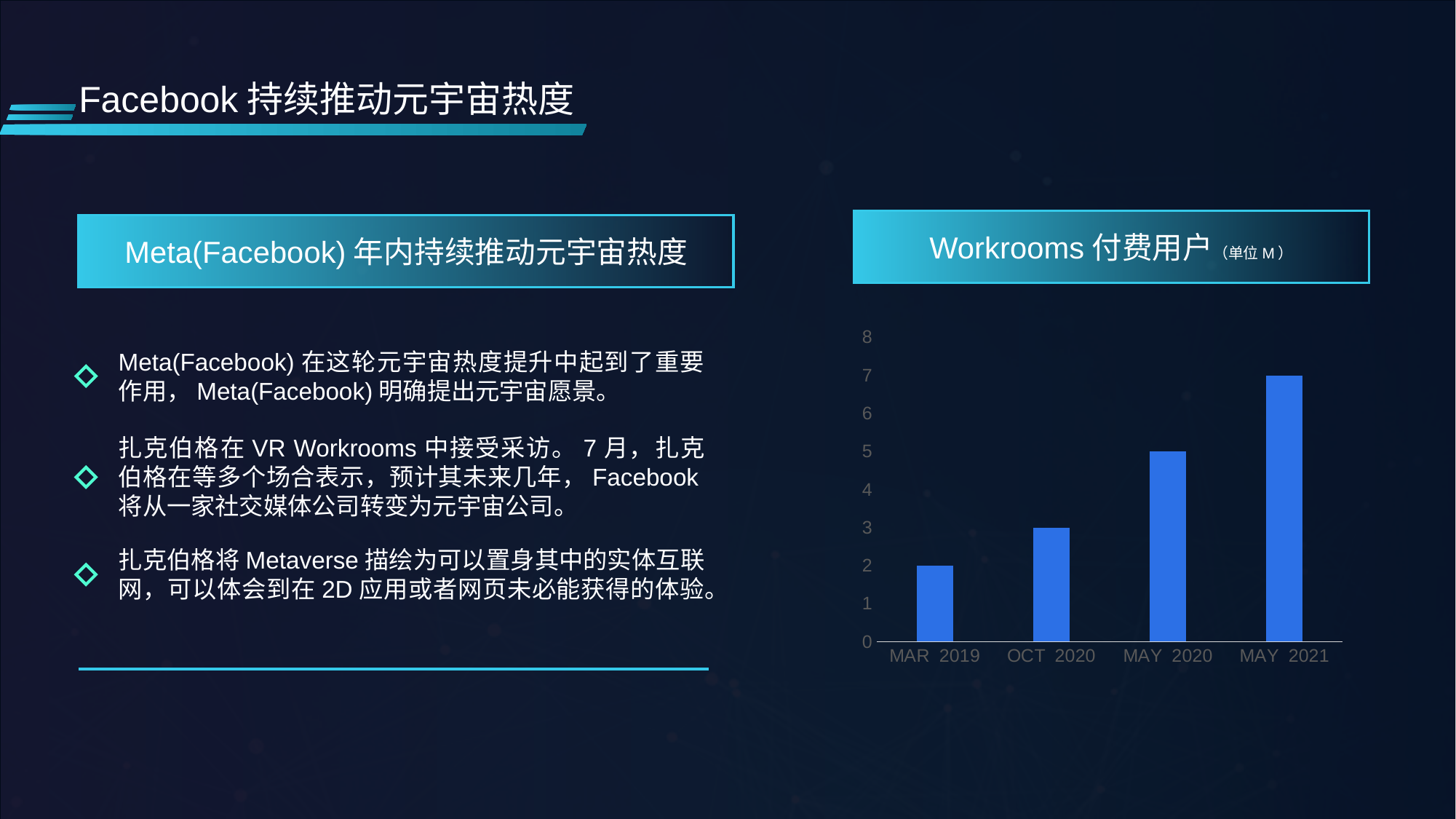
Which category has the lowest value in the chart? MAR 2019 What is the value for OCT 2020 in the chart? 3 What is the difference between the values for MAY 2021 and MAR 2019? 5 What is the value for MAY 2021 in the chart? 7 Which is larger, the value for OCT 2020 or the value for MAY 2020? MAY 2020 How many categories are shown on the x axis of the chart? 4 Which category has the highest value in the chart? MAY 2021 What is the value for MAY 2020 in the chart? 5 What is the value for MAR 2019 in the chart? 2 What unit is given in the chart's title? M What kind of chart is shown on the slide? bar chart Do the values rise or fall from left to right along the x axis? rise